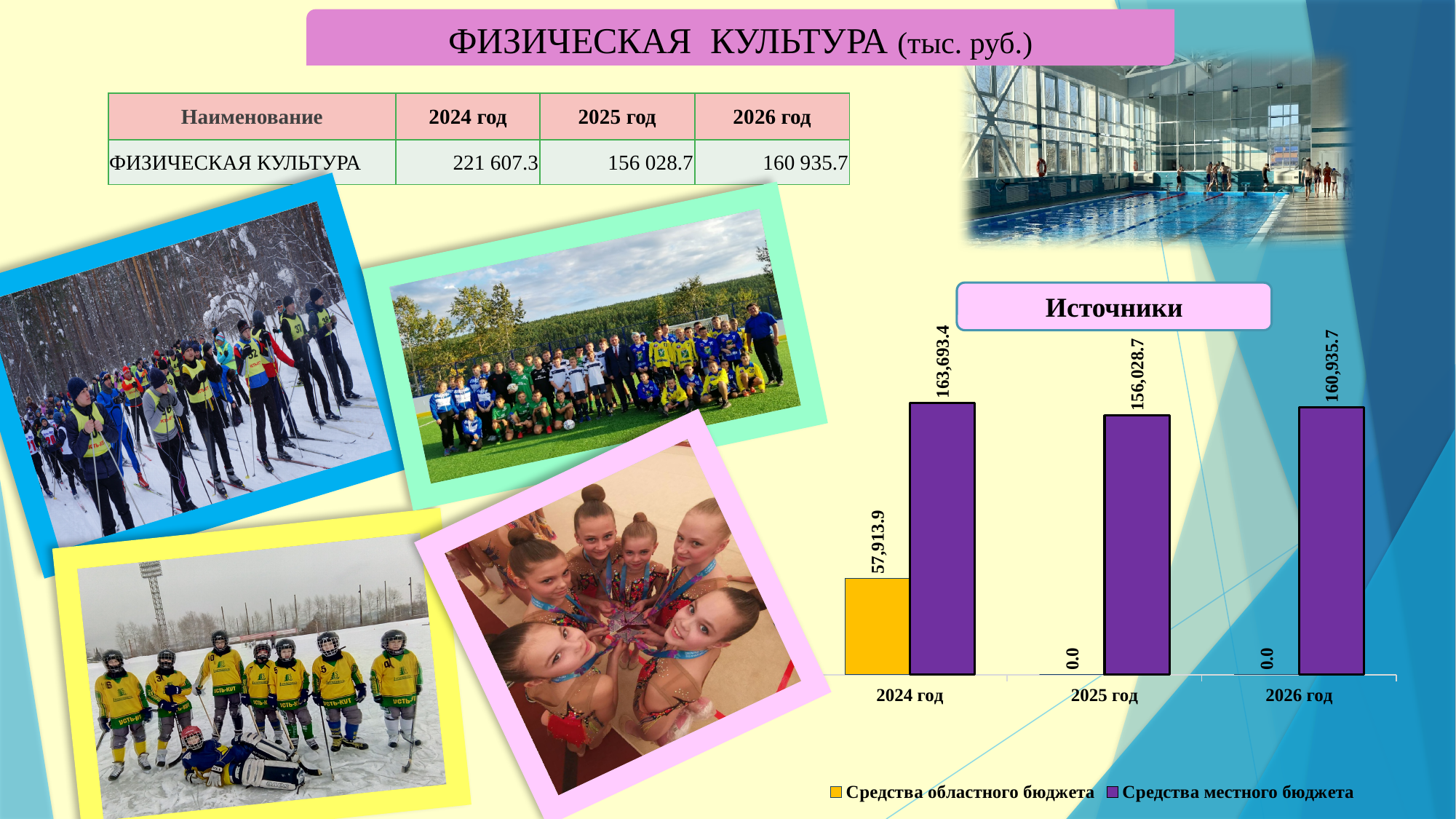
What type of chart is shown under the heading "Источники"? bar chart In the "Источники" chart, what is the value of "Средства местного бюджета" for 2024 год? 163,693.4 In the "Источники" chart, which year has the lowest value for "Средства местного бюджета"? 2025 год In the "Источники" chart, what is the value of "Средства областного бюджета" for 2024 год? 57,913.9 How many series does the legend of the "Источники" chart list? 2 In the "Источники" chart, what is the difference between "Средства местного бюджета" and "Средства областного бюджета" for 2024 год? 105,779.5 In the "Источники" chart, what colour are the bars for "Средства местного бюджета"? purple How many year categories are shown on the x axis of the "Источники" chart? 3 In the "Источники" chart, which is larger for 2024 год: "Средства областного бюджета" or "Средства местного бюджета"? Средства местного бюджета In the "Источники" chart, what is the value of "Средства местного бюджета" for 2025 год? 156,028.7 In the "Источники" chart, what is the value of "Средства областного бюджета" for 2026 год? 0.0 In the "Источники" chart, which year has the highest value for "Средства местного бюджета"? 2024 год